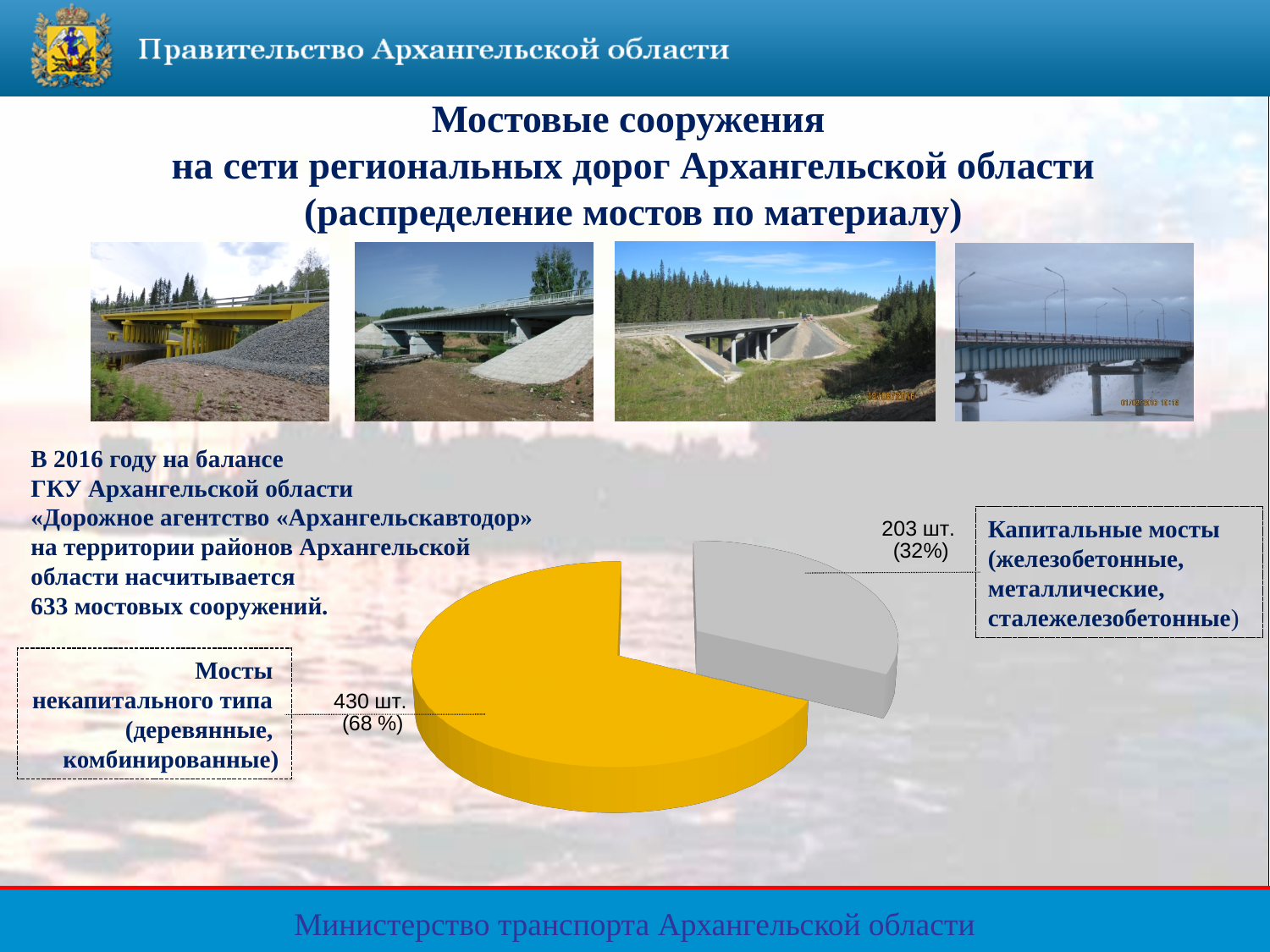
What colour is the slice for non-capital bridges (мосты некапитального типа) in the pie chart? yellow What is the difference in the number of bridges between non-capital bridges and capital bridges? 227 шт. What is the total number of bridges represented by the two slices of the pie chart? 633 What kind of chart is shown on the slide? pie chart What share of the pie do capital bridges (капитальные мосты) represent? 32% Which slice of the pie chart is the smallest? Капитальные мосты (железобетонные, металлические, сталежелезобетонные) Which is larger: the number of capital bridges or the number of non-capital bridges? non-capital bridges (мосты некапитального типа) How many slices does the pie chart have? 2 How many capital bridges (капитальные мосты) does the pie chart show? 203 шт. What share of the pie do non-capital bridges (мосты некапитального типа) represent? 68 % Which slice of the pie chart is the largest? Мосты некапитального типа (деревянные, комбинированные) How many bridges of non-capital type (мосты некапитального типа) does the pie chart show? 430 шт.